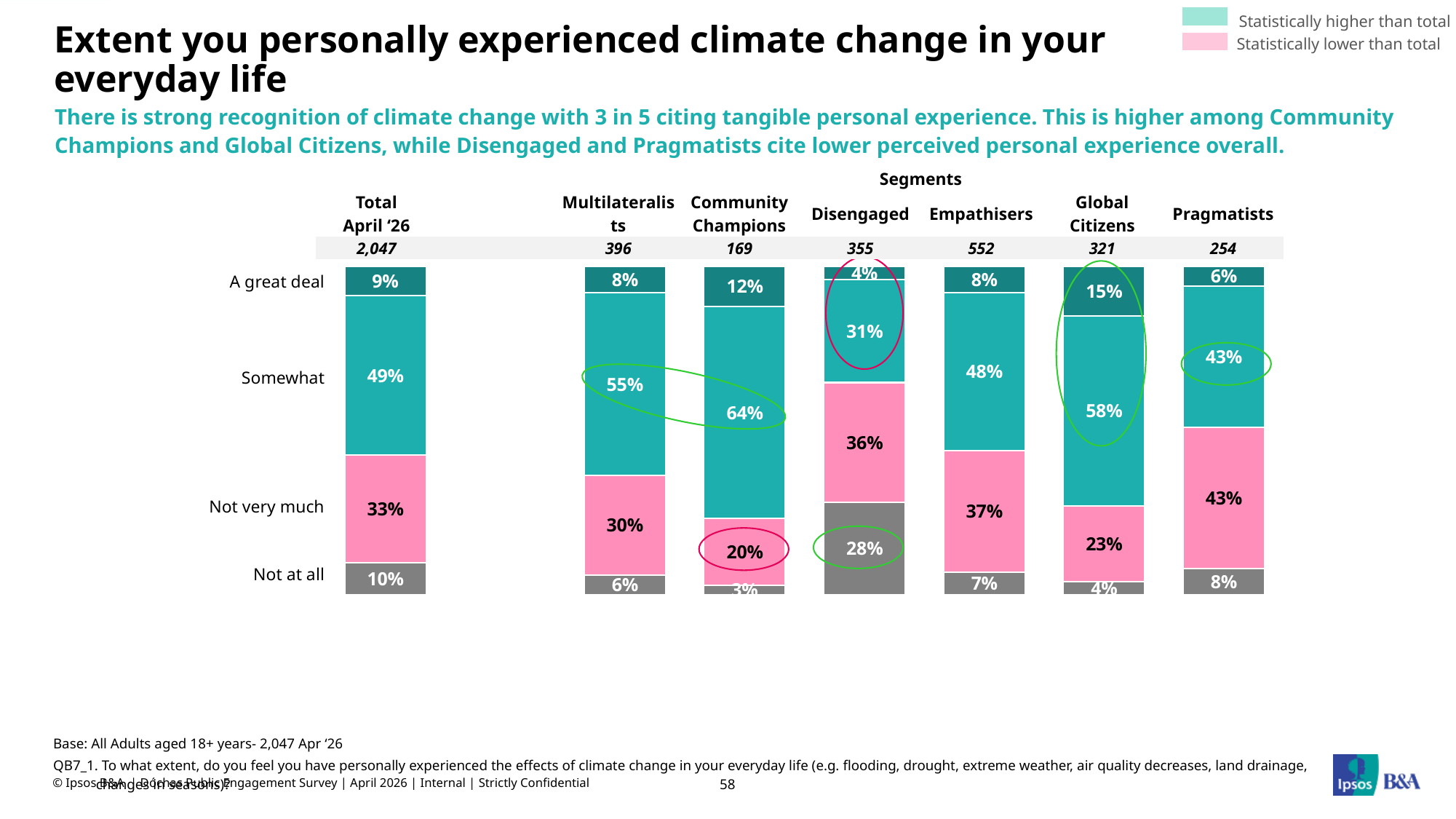
What type of chart is used on this slide? Stacked bar chart Which is larger: the 'Somewhat' value for Multilateralists or for Empathisers? Multilateralists Which segment has the highest 'Somewhat' value? Community Champions What is the difference between the 'Not very much' values for Pragmatists and Community Champions? 23% What percentage of the Disengaged segment said 'Not at all'? 28% What percentage of Global Citizens said 'A great deal'? 15% What percentage of the Total April '26 group said they experienced climate change 'Somewhat'? 49% Which segment has the lowest 'A great deal' value? Disengaged What is the total of the Global Citizens stacked bar? 100% What percentage of Pragmatists said 'Not very much'? 43% What is the base size shown for the Disengaged segment? 355 How many bars (groups) are shown in the chart? 7